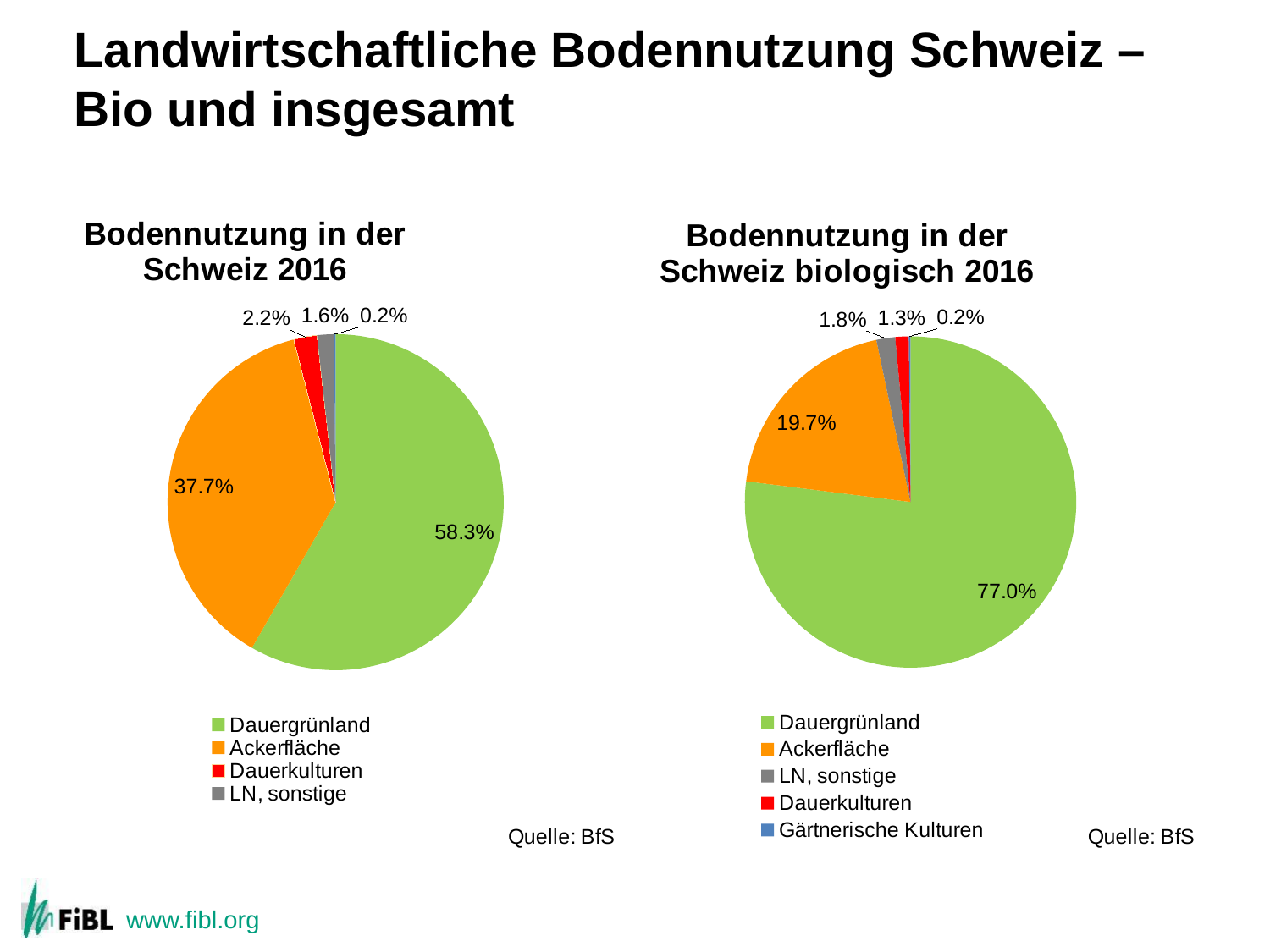
What is the difference between the Dauergrünland share in the 'Bodennutzung in der Schweiz biologisch 2016' chart and in the 'Bodennutzung in der Schweiz 2016' chart? 18.7% In the chart 'Bodennutzung in der Schweiz biologisch 2016', what share does Dauergrünland have? 77.0% In the chart 'Bodennutzung in der Schweiz biologisch 2016', which category has the largest share? Dauergrünland In the chart 'Bodennutzung in der Schweiz 2016', what share does Dauergrünland have? 58.3% What type of chart is used on the left side of the slide? Pie chart In the chart 'Bodennutzung in der Schweiz 2016', what share does Dauerkulturen have? 2.2% How many entries does the legend of the chart 'Bodennutzung in der Schweiz biologisch 2016' list? 5 In the chart 'Bodennutzung in der Schweiz biologisch 2016', what share does LN, sonstige have? 1.8% In the chart 'Bodennutzung in der Schweiz biologisch 2016', what share does Ackerfläche have? 19.7% In the chart 'Bodennutzung in der Schweiz biologisch 2016', which category has the smallest share? Gärtnerische Kulturen In the chart 'Bodennutzung in der Schweiz 2016', which is larger, Dauerkulturen or LN, sonstige? Dauerkulturen In the chart 'Bodennutzung in der Schweiz 2016', what share does Ackerfläche have? 37.7%